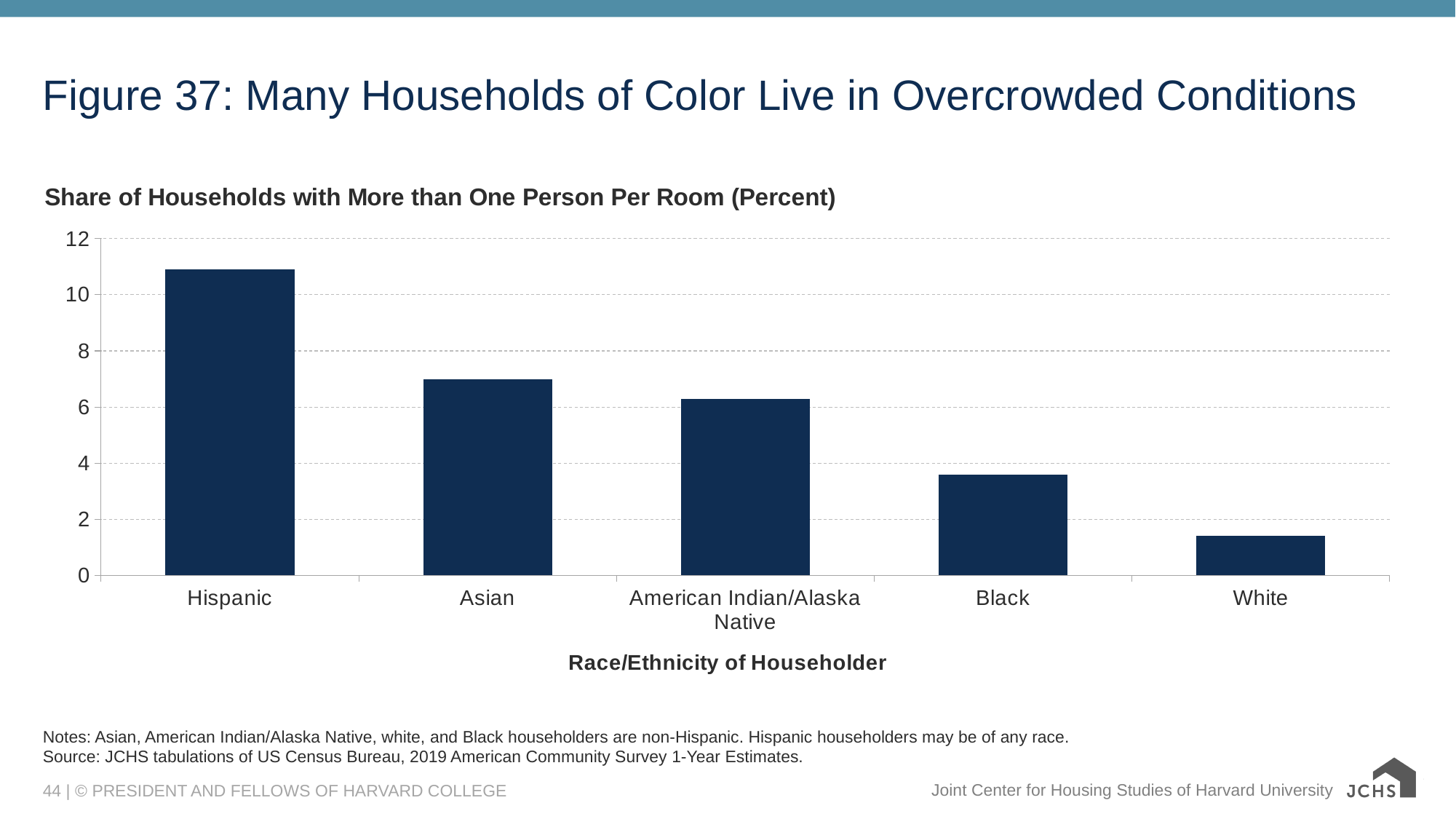
Is the value for White householders greater or less than 2? less What kind of chart is shown on the slide? bar chart Is the value for Hispanic householders greater or less than 10? greater Is the value for Asian householders greater or less than 8? less Do the values rise or fall moving from left to right across the categories? fall Which race/ethnicity of householder has the highest share of households with more than one person per room? Hispanic How many race/ethnicity categories are shown on the chart? 5 Which is larger, the value for Asian householders or the value for Black householders? Asian Which race/ethnicity of householder has the lowest share of households with more than one person per room? White What is the label of the x axis? Race/Ethnicity of Householder